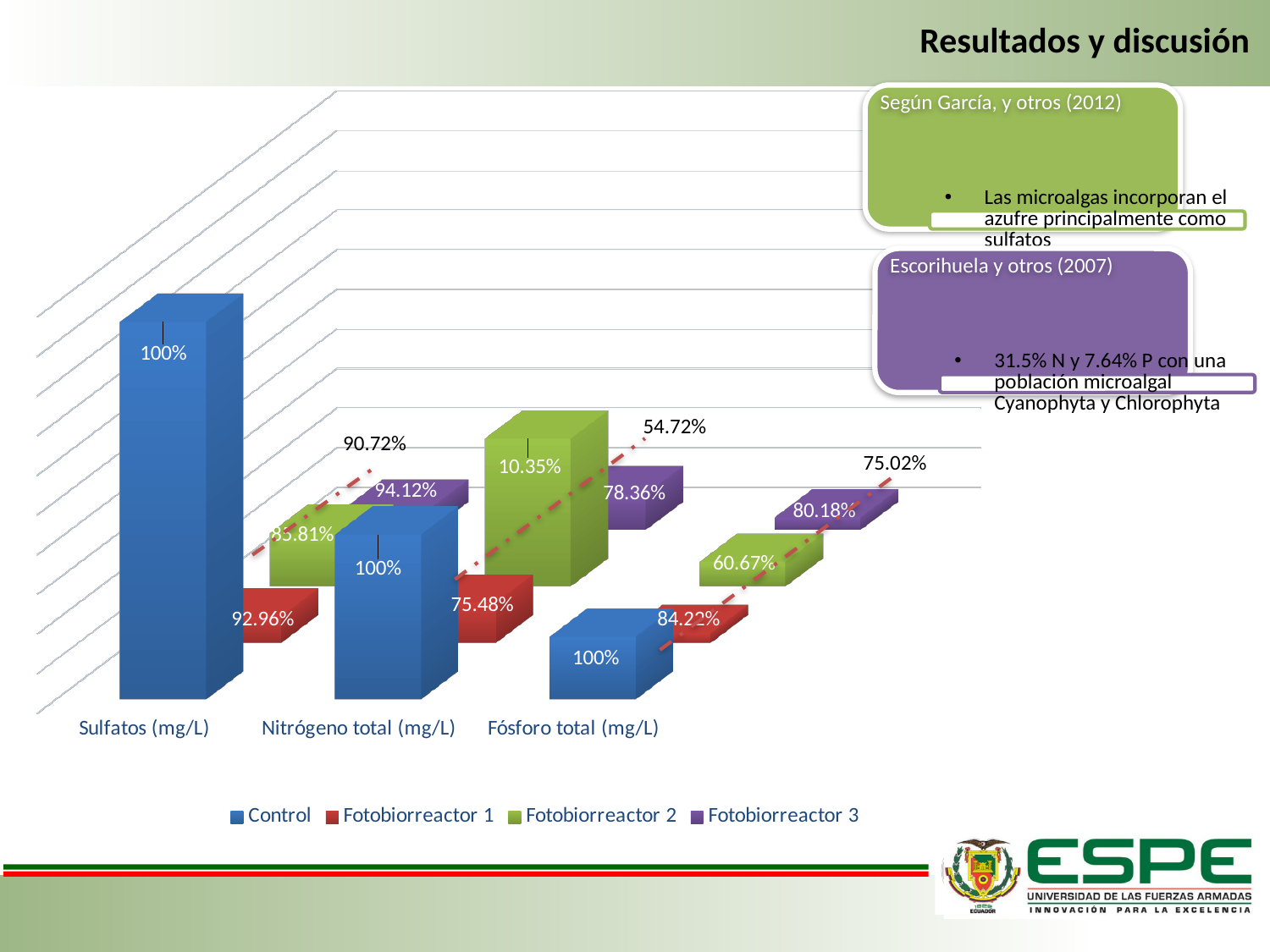
What is the value for Fotobiorreactor 2 in the Nitrógeno total (mg/L) category? 10.35% How many series does the legend list? 4 What is the value for Fotobiorreactor 3 in the Fósforo total (mg/L) category? 80.18% What is the value for Fotobiorreactor 1 in the Nitrógeno total (mg/L) category? 75.48% What is the value for Fotobiorreactor 2 in the Fósforo total (mg/L) category? 60.67% What is the value for Control in the Sulfatos (mg/L) category? 100% What is the value for Fotobiorreactor 1 in the Sulfatos (mg/L) category? 92.96% What kind of chart is shown on the slide? Bar chart How many categories are shown on the x axis of the chart? 3 What is the value for Fotobiorreactor 3 in the Sulfatos (mg/L) category? 94.12%